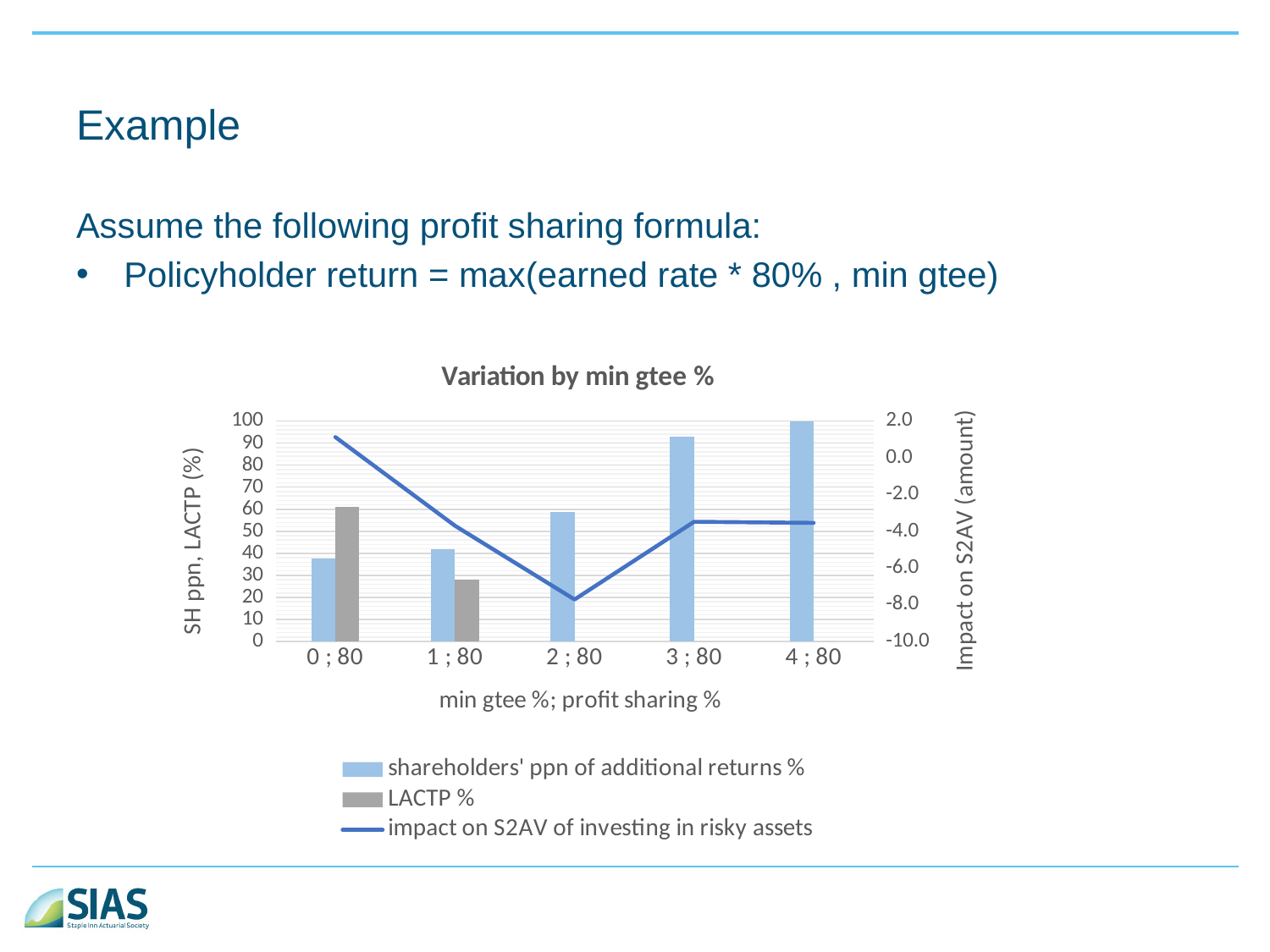
Is the shareholders' ppn of additional returns % larger for 3 ; 80 or for 1 ; 80? 3 ; 80 How many categories are shown on the x axis of the chart? 5 For which category is the shareholders' ppn of additional returns % lowest? 0 ; 80 For which category is the shareholders' ppn of additional returns % highest? 4 ; 80 What is the title of the chart? Variation by min gtee % For which category is the impact on S2AV of investing in risky assets lowest? 2 ; 80 Is the shareholders' ppn of additional returns % for 0 ; 80 greater or less than 50? less Is the impact on S2AV of investing in risky assets for 2 ; 80 greater or less than -6.0? less What type of chart is shown on the slide? Combined bar and line chart Is the LACTP % value for 0 ; 80 greater or less than 50? greater Does the impact on S2AV of investing in risky assets line rise or fall from 0 ; 80 to 2 ; 80? fall How many series does the chart legend list? 3